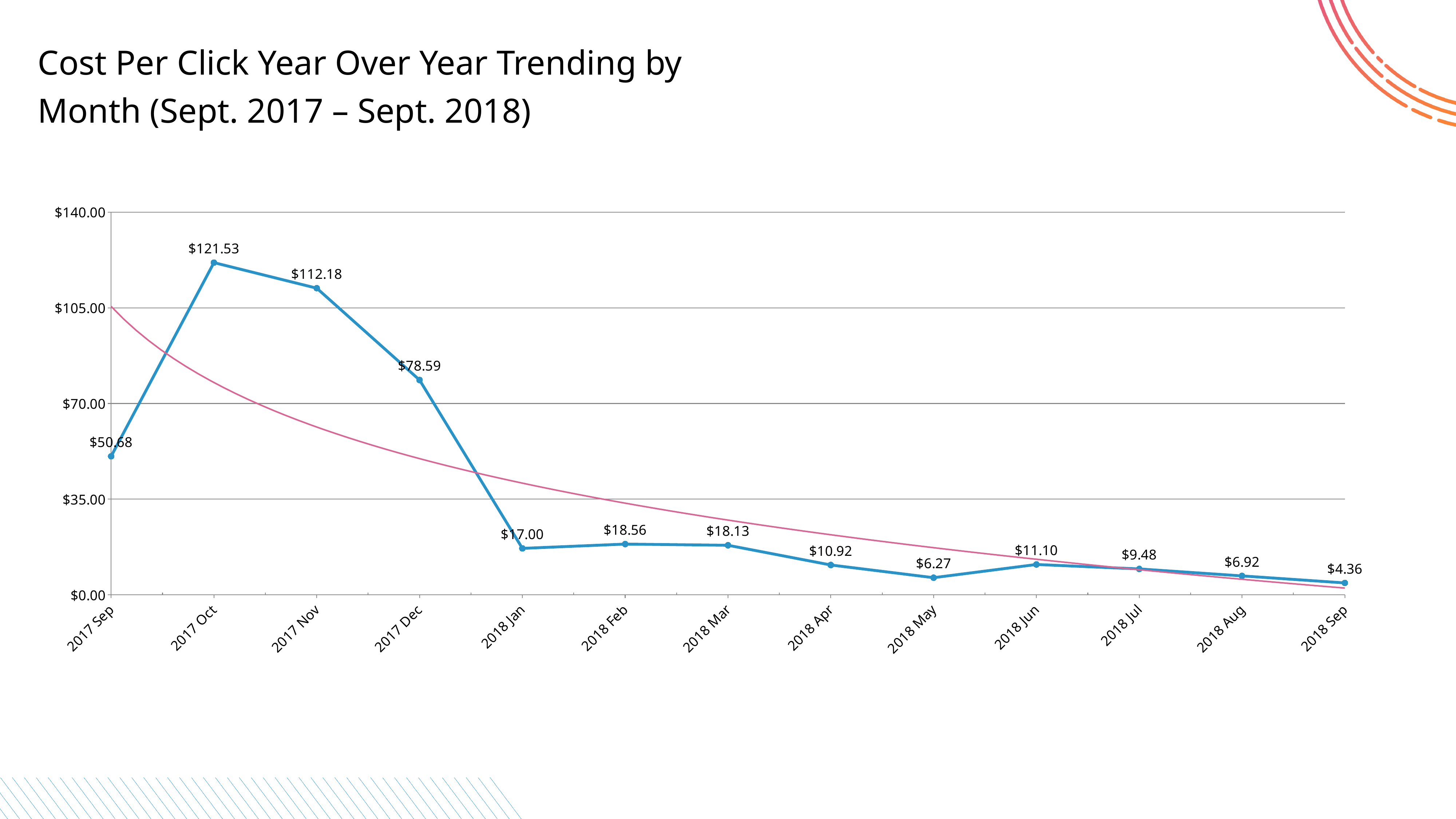
What is the cost per click for 2017 Oct? $121.53 How many months are plotted on the chart? 13 Which month has the lowest cost per click? 2018 Sep What is the difference in cost per click between 2017 Oct and 2017 Nov? $9.35 What is the cost per click for 2018 Sep? $4.36 Which has a higher cost per click, 2018 Jun or 2018 Jul? 2018 Jun What kind of chart is shown on the slide? line chart What is the cost per click for 2018 May? $6.27 Which month has the highest cost per click? 2017 Oct Is the cost per click for 2017 Dec greater or less than $70.00? greater Does the cost per click rise or fall from 2017 Dec to 2018 Jan? fall What is the title of the slide? Cost Per Click Year Over Year Trending by Month (Sept. 2017 – Sept. 2018)